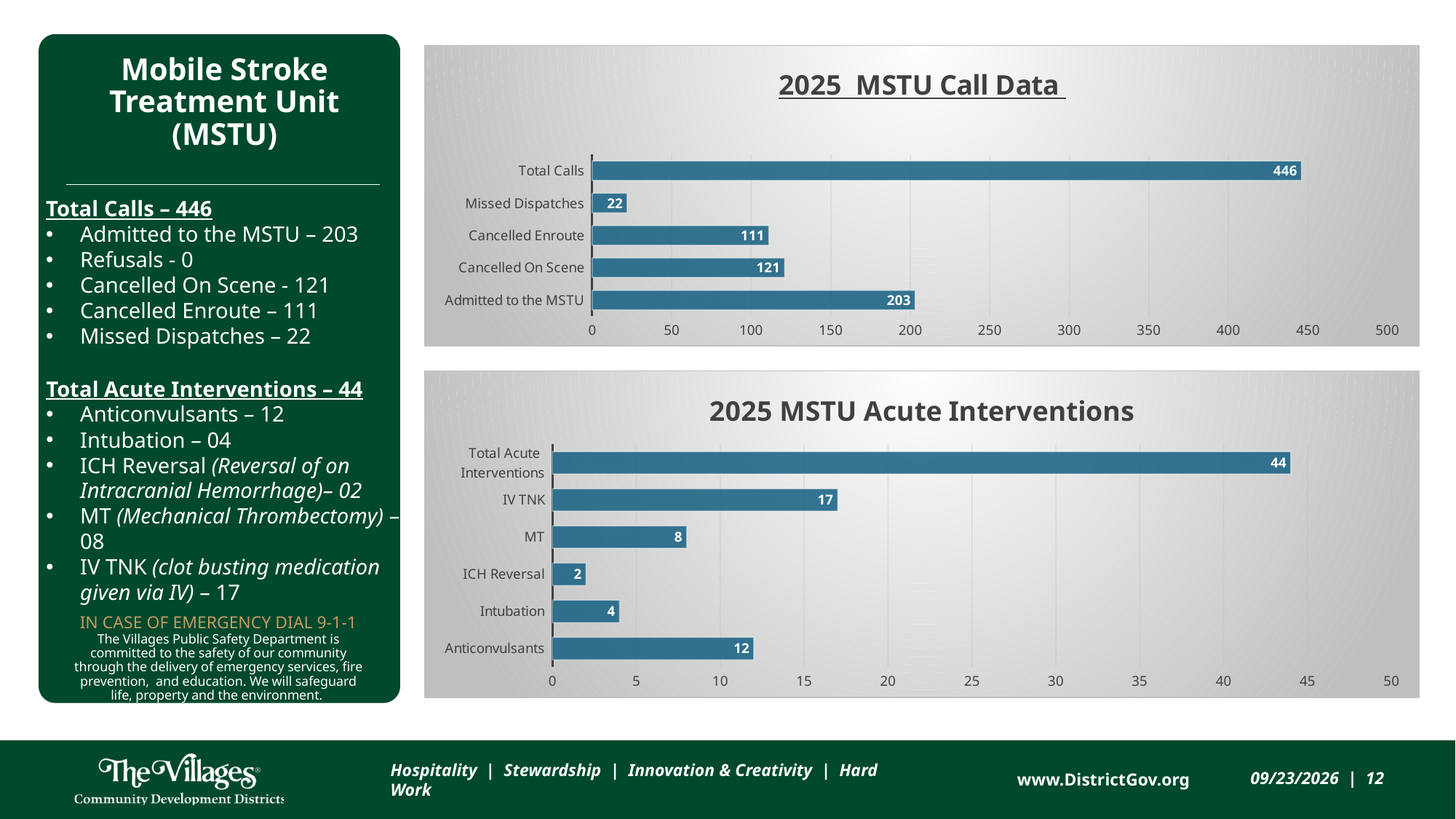
In the 2025 MSTU Call Data chart, what is the value for Cancelled On Scene? 121 In the 2025 MSTU Call Data chart, how many categories are plotted? 5 In the 2025 MSTU Acute Interventions chart, how many categories are plotted? 6 In the 2025 MSTU Acute Interventions chart, what is the value for IV TNK? 17 In the 2025 MSTU Acute Interventions chart, which is larger, MT or Anticonvulsants? Anticonvulsants What kind of chart is the 2025 MSTU Call Data chart? Bar chart In the 2025 MSTU Acute Interventions chart, what is the difference between IV TNK and Intubation? 13 In the 2025 MSTU Call Data chart, which category has the lowest value? Missed Dispatches In the 2025 MSTU Call Data chart, what is the value for Missed Dispatches? 22 In the 2025 MSTU Call Data chart, what is the difference between Cancelled On Scene and Cancelled Enroute? 10 In the 2025 MSTU Acute Interventions chart, what is the value for ICH Reversal? 2 In the 2025 MSTU Acute Interventions chart, which category has the lowest value? ICH Reversal